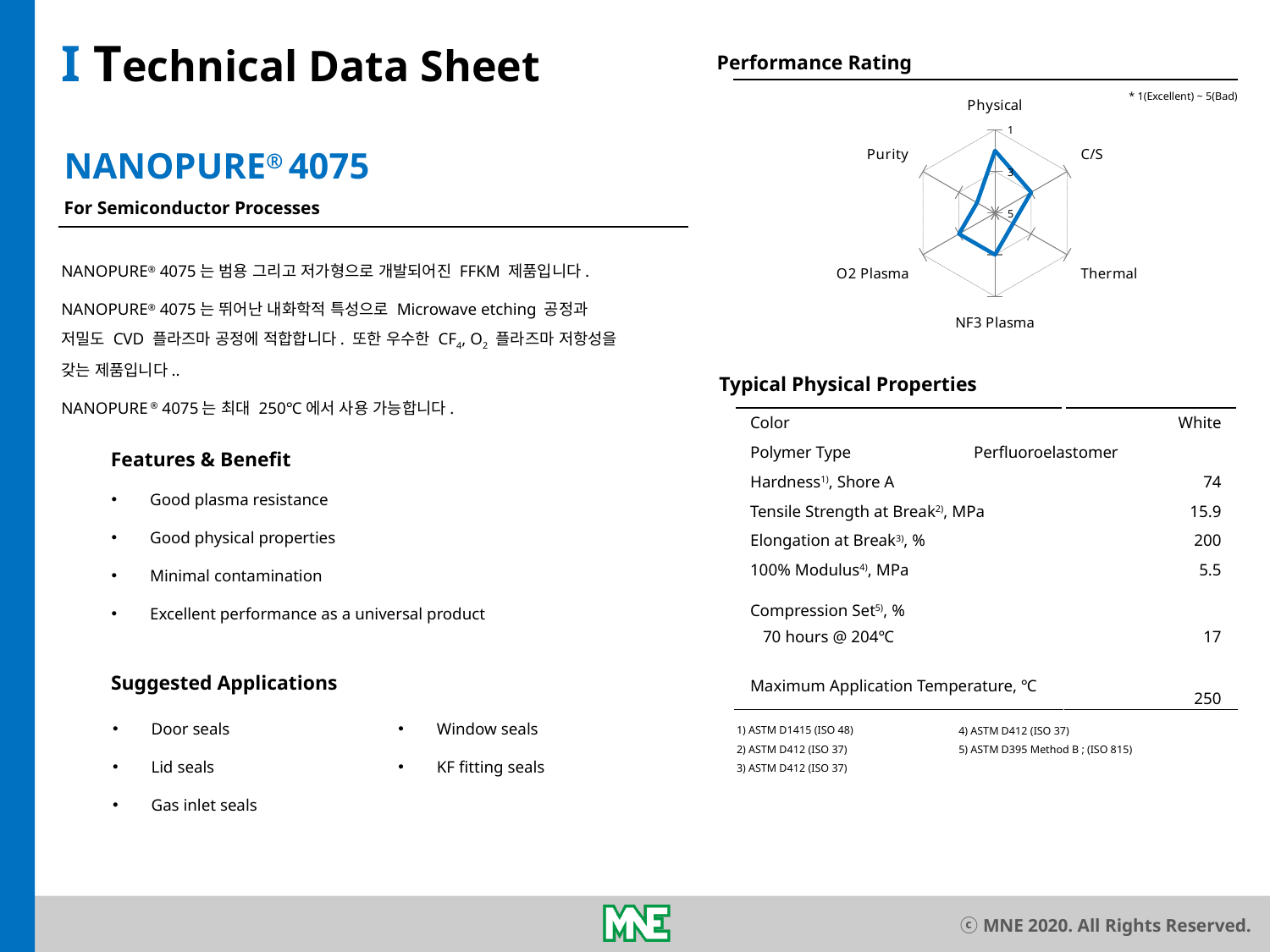
What kind of chart is shown under the heading "Performance Rating"? Radar chart On the Performance Rating chart, is the rating for Physical greater or less than 3? less How many performance categories are plotted on the Performance Rating radar chart? 6 What is the highest (worst) rating value shown on the Performance Rating chart's scale? 5 Which category is plotted at the top of the Performance Rating radar chart? Physical According to the note on the Performance Rating chart, what rating value means Excellent? 1 On the Performance Rating chart, which category has the better (lower) rating, Physical or Purity? Physical